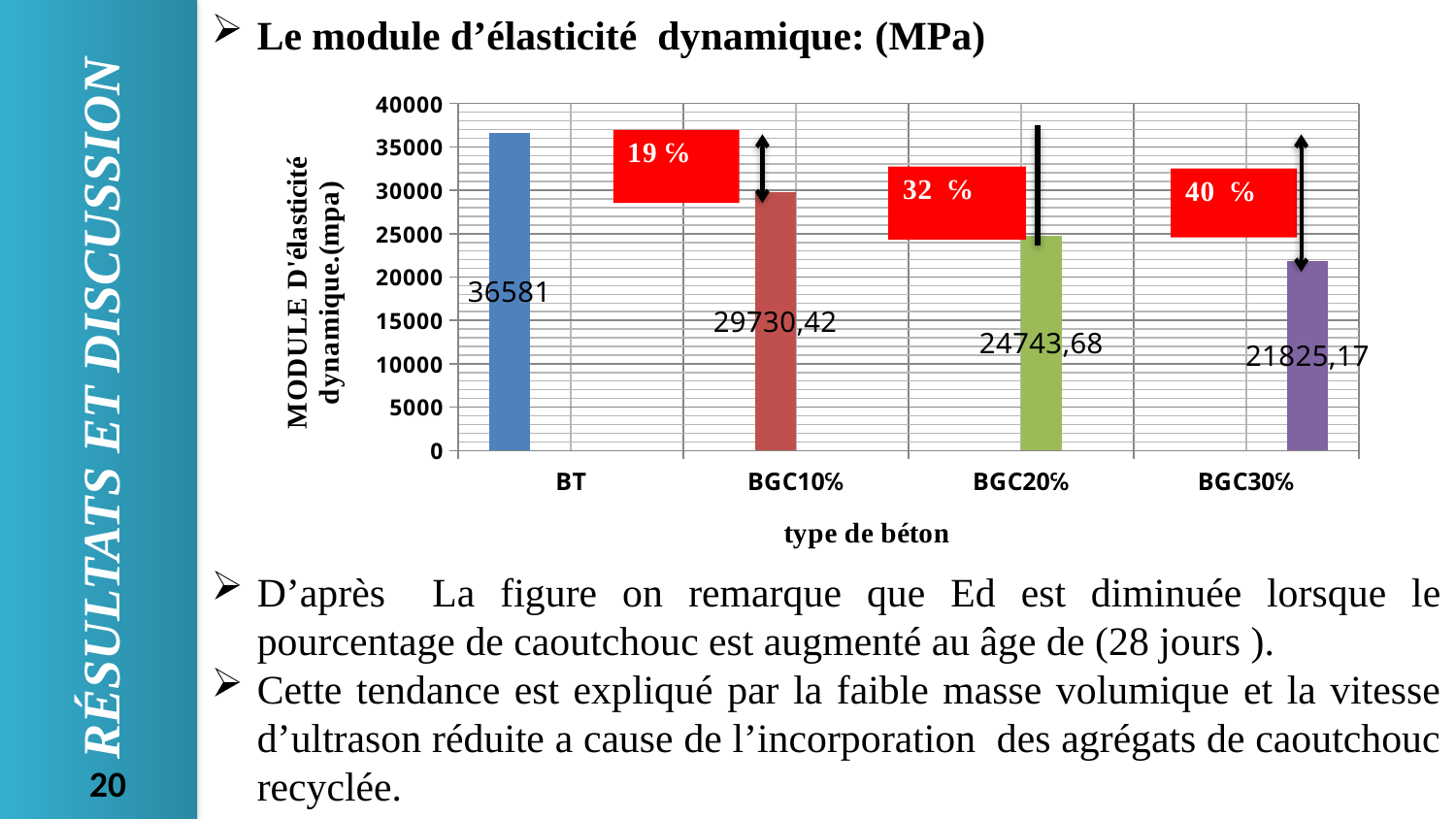
How many types of concrete are plotted on the x axis? 4 Which type of concrete has the lowest dynamic elasticity modulus? BGC30% What is the value shown for BGC20%? 24743,68 What is the difference between the values for BT and BGC10%? 6850,58 Which has a larger value, BGC10% or BGC20%? BGC10% What is the value shown for BGC10%? 29730,42 What is the value shown for BGC30%? 21825,17 What kind of chart is shown on the slide? Bar chart Which type of concrete has the highest dynamic elasticity modulus? BT What is the difference between the values for BT and BGC30%? 14755,83 What is the dynamic elasticity modulus value shown for BT? 36581 Do the values rise or fall from BT to BGC30% along the x axis? Fall